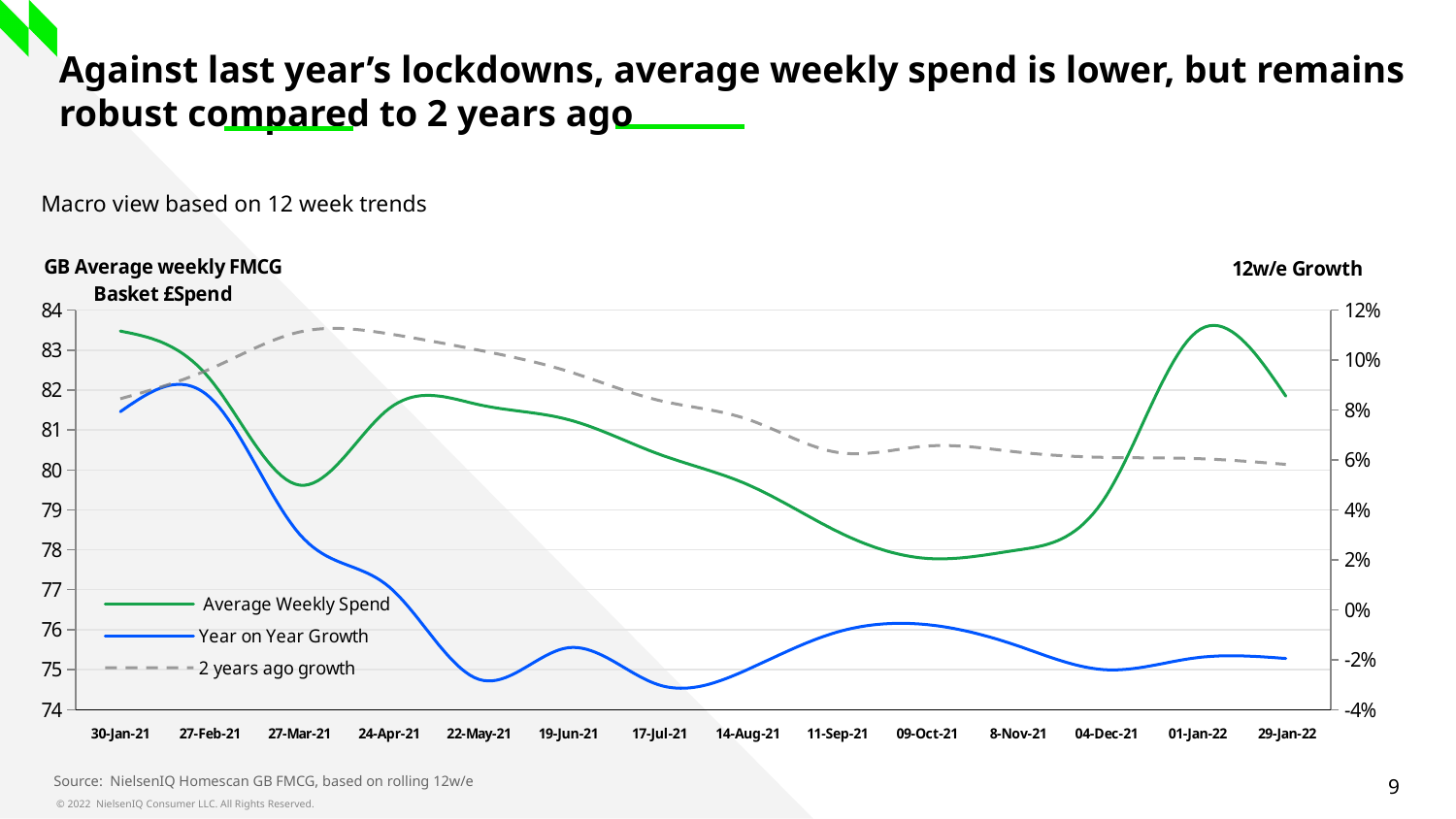
Which is larger, Average Weekly Spend on 27-Mar-21 or on 24-Apr-21? 24-Apr-21 Is the Year on Year Growth value for 22-May-21 greater or less than 0%? less Is the Year on Year Growth value for 27-Feb-21 greater or less than 8%? greater Does the 2 years ago growth line rise or fall from 27-Mar-21 to 29-Jan-22? fall Is the 2 years ago growth value for 29-Jan-22 greater or less than 8%? less On which date is Year on Year Growth at its highest? 27-Feb-21 What kind of chart is shown on the slide? line chart How many dates are labelled on the x axis? 14 How many series does the legend list? 3 Which series is drawn as a dashed line? 2 years ago growth